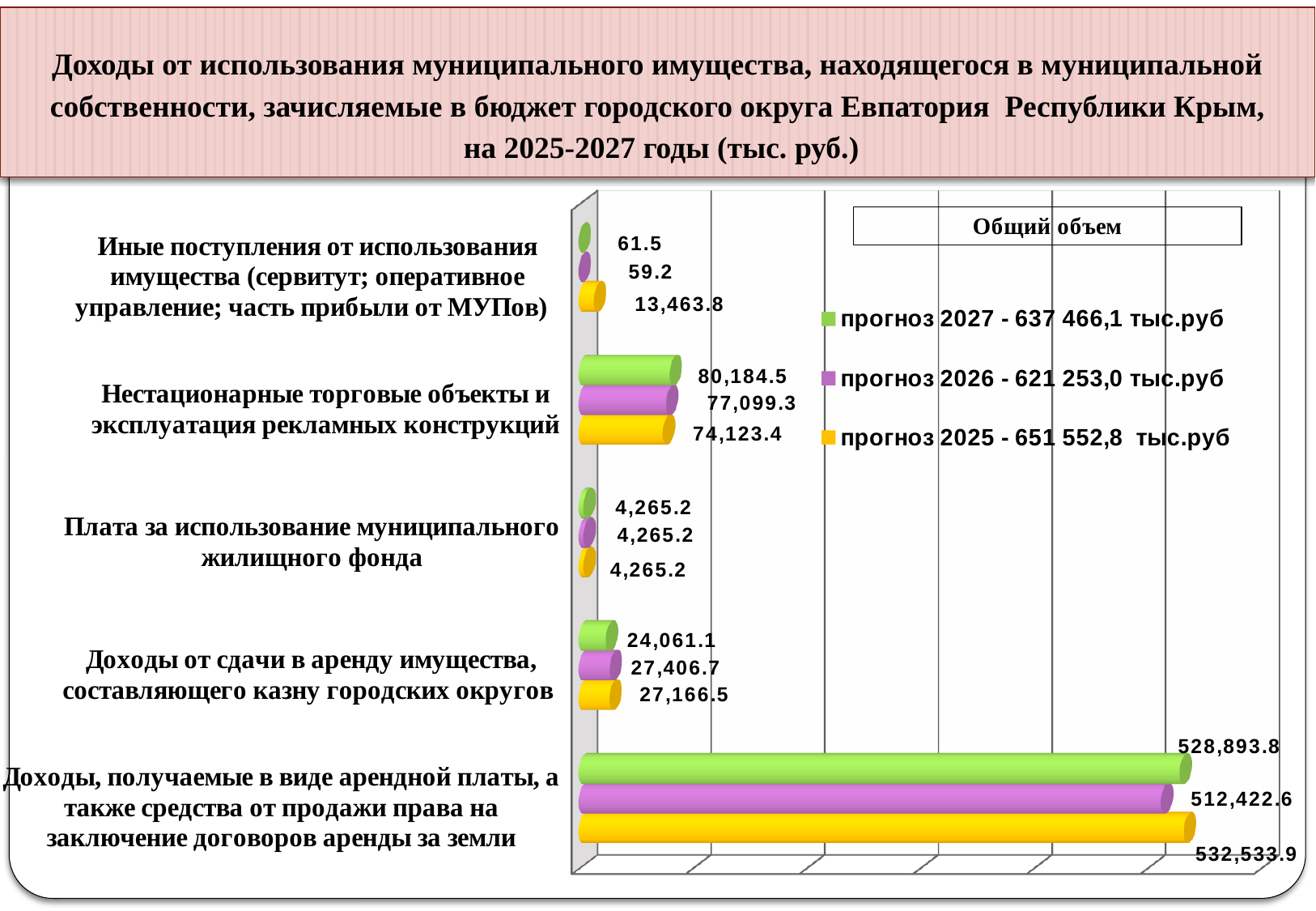
What is the difference between the прогноз 2027 and прогноз 2025 values for 'Нестационарные торговые объекты и эксплуатация рекламных конструкций'? 6,061.1 What is the difference between the прогноз 2025 and прогноз 2026 values for 'Доходы, получаемые в виде арендной платы, а также средства от продажи права на заключение договоров аренды за земли'? 20,111.3 According to the legend, what is the total volume (Общий объем) for прогноз 2025? 651 552,8 тыс.руб How many series does the legend list? 3 What is the прогноз 2027 value for 'Нестационарные торговые объекты и эксплуатация рекламных конструкций'? 80,184.5 Which category has the highest прогноз 2025 value? Доходы, получаемые в виде арендной платы, а также средства от продажи права на заключение договоров аренды за земли Which category has the lowest прогноз 2027 value? Иные поступления от использования имущества (сервитут; оперативное управление; часть прибыли от МУПов) For 'Доходы от сдачи в аренду имущества, составляющего казну городских округов', which is larger: the прогноз 2026 value or the прогноз 2027 value? прогноз 2026 What is the прогноз 2025 value for 'Иные поступления от использования имущества (сервитут; оперативное управление; часть прибыли от МУПов)'? 13,463.8 How many categories are plotted on the chart? 5 What type of chart is shown on the slide? bar chart What is the прогноз 2026 value for 'Доходы от сдачи в аренду имущества, составляющего казну городских округов'? 27,406.7